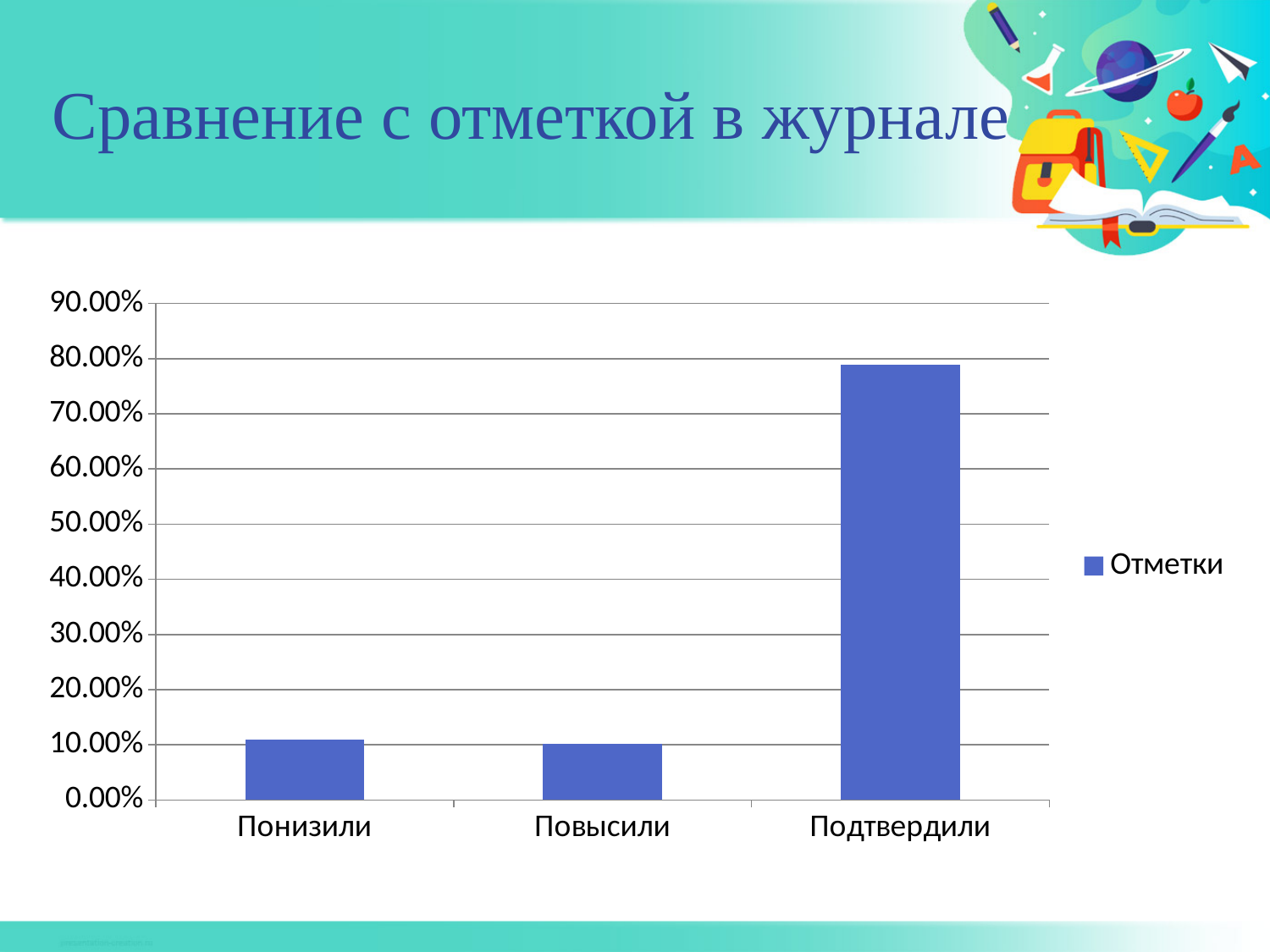
Is the value for Подтвердили greater or less than 70.00%? greater Which is larger, the value for Подтвердили or the value for Понизили? Подтвердили How many series does the chart legend list? 1 What is the name of the series shown in the chart legend? Отметки How many categories are shown on the x axis of the chart? 3 Is the value for Понизили greater or less than 20.00%? less What is the title of the slide containing the chart? Сравнение с отметкой в журнале Is the value for Подтвердили greater or less than 80.00%? less Which category has the highest value in the chart? Подтвердили What kind of chart is shown on the slide? bar chart Which is larger, the value for Повысили or the value for Подтвердили? Подтвердили